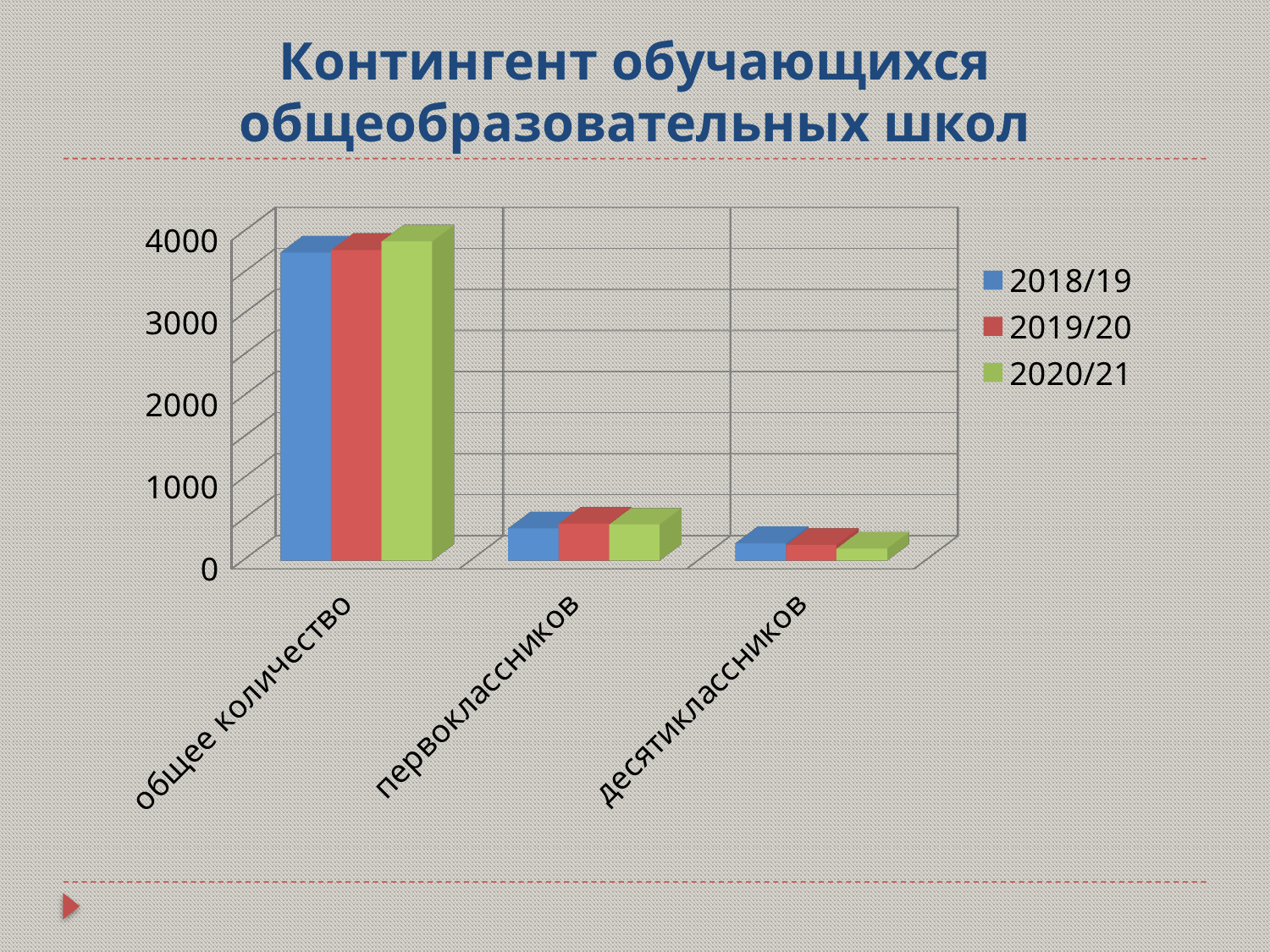
For 2018/19, which is larger: первоклассников or десятиклассников? первоклассников What kind of chart is shown on the slide? bar chart How many series does the chart's legend list? 3 Which category has the lowest values in the chart? десятиклассников How many categories are shown on the x axis of the chart? 3 What is the title of the slide containing the chart? Контингент обучающихся общеобразовательных школ Which series is shown in green in the chart's legend? 2020/21 Is the value for общее количество in 2018/19 greater or less than 3000? greater Is the value for десятиклассников in 2020/21 greater or less than 1000? less Is the value for первоклассников in 2019/20 greater or less than 1000? less Which category has the highest values in the chart? общее количество